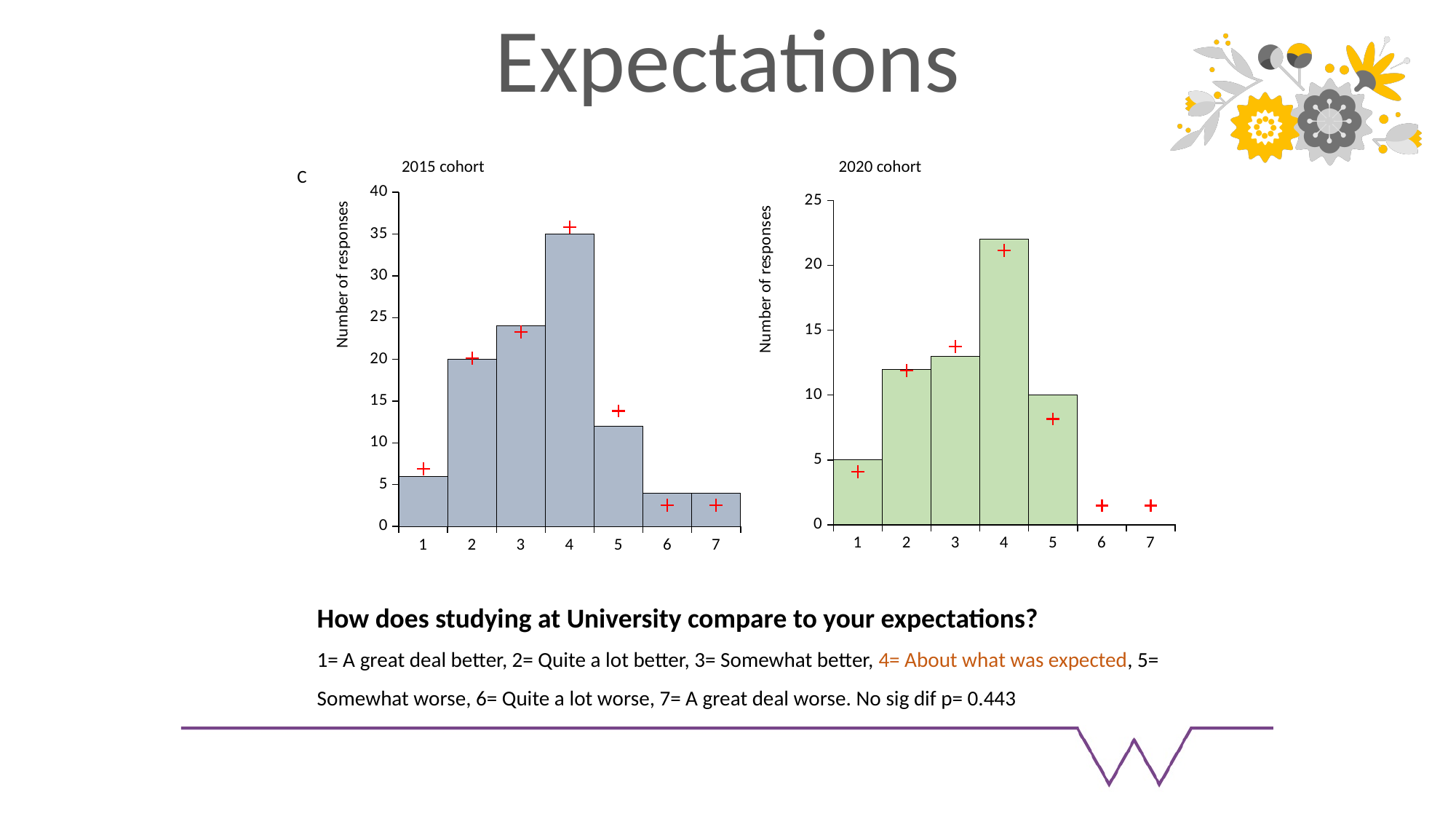
In the 2015 cohort chart, is the value for category 3 greater or less than 20? greater How many categories are shown on the x axis of the 2020 cohort chart? 7 In the 2015 cohort chart, what is the difference between the number of responses for category 4 and category 2? 15 In the 2020 cohort chart, is the value for category 4 greater or less than 20? greater What type of chart is the 2015 cohort chart? bar chart In the 2015 cohort chart, which category has the highest number of responses? 4 In the 2020 cohort chart, which category has the highest number of responses? 4 In the 2015 cohort chart, how many responses are shown for category 4? 35 In the 2020 cohort chart, how many responses are shown for category 1? 5 In the 2015 cohort chart, which has more responses, category 2 or category 5? 2 In the 2020 cohort chart, how many responses are shown for category 5? 10 In the 2015 cohort chart, how many responses are shown for category 2? 20